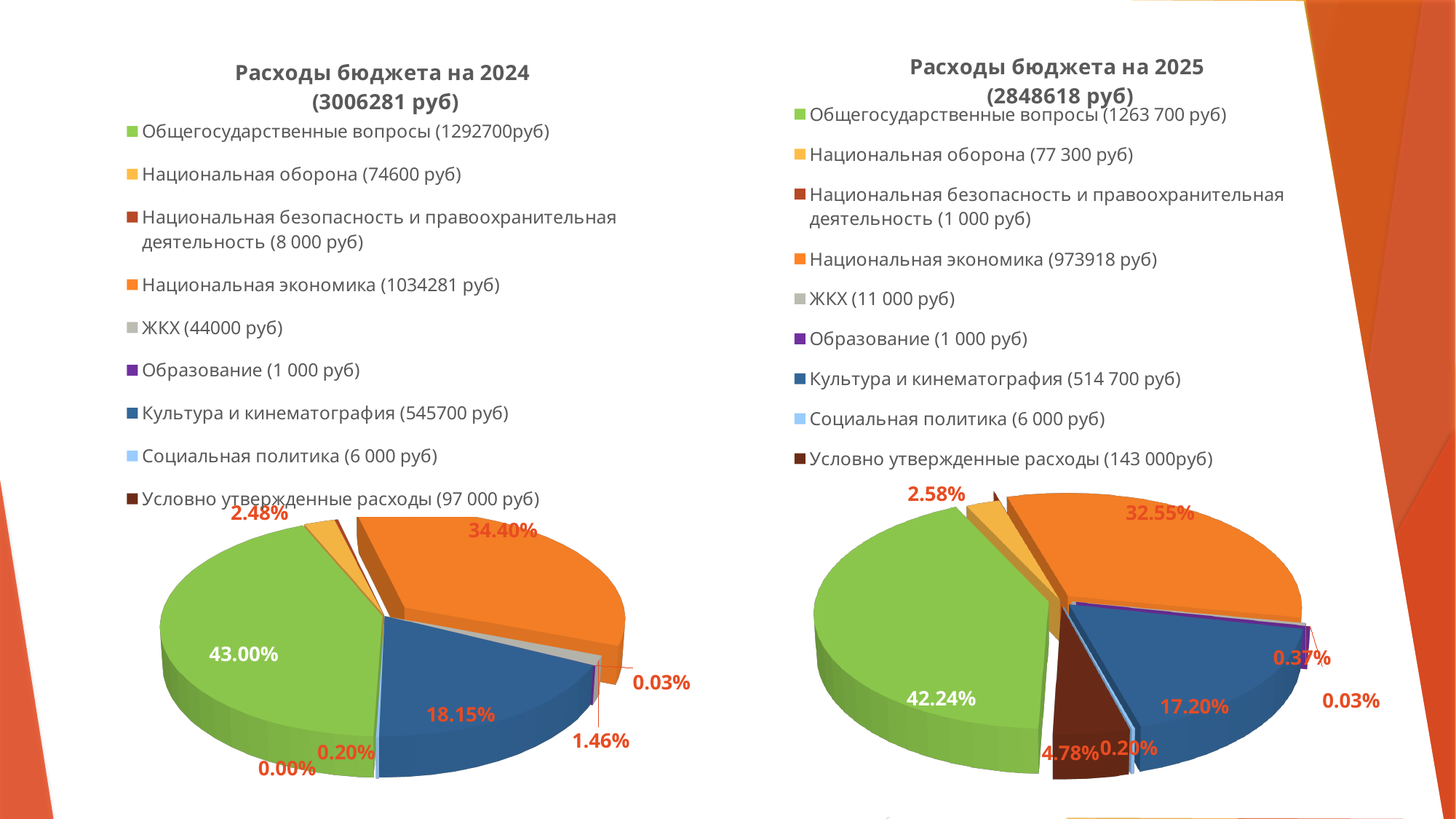
In the 'Расходы бюджета на 2025' chart, which is larger: the share of Культура и кинематография or the share of Национальная оборона? Культура и кинематография In the 'Расходы бюджета на 2025' chart, what share is shown for Национальная экономика? 32.55% What total budget amount is shown in the title of the 'Расходы бюджета на 2025' chart? 2848618 руб How many categories does the legend of the 'Расходы бюджета на 2025' chart list? 9 In the 'Расходы бюджета на 2025' chart, what share is shown for Общегосударственные вопросы? 42.24% According to the legend of the 'Расходы бюджета на 2024' chart, what amount is given for Культура и кинематография? 545700 руб In the 'Расходы бюджета на 2024' chart, what share is shown for Национальная экономика? 34.40% In the 'Расходы бюджета на 2024' chart, which category has the largest share? Общегосударственные вопросы What kind of chart is the 'Расходы бюджета на 2024' chart on the left? pie chart